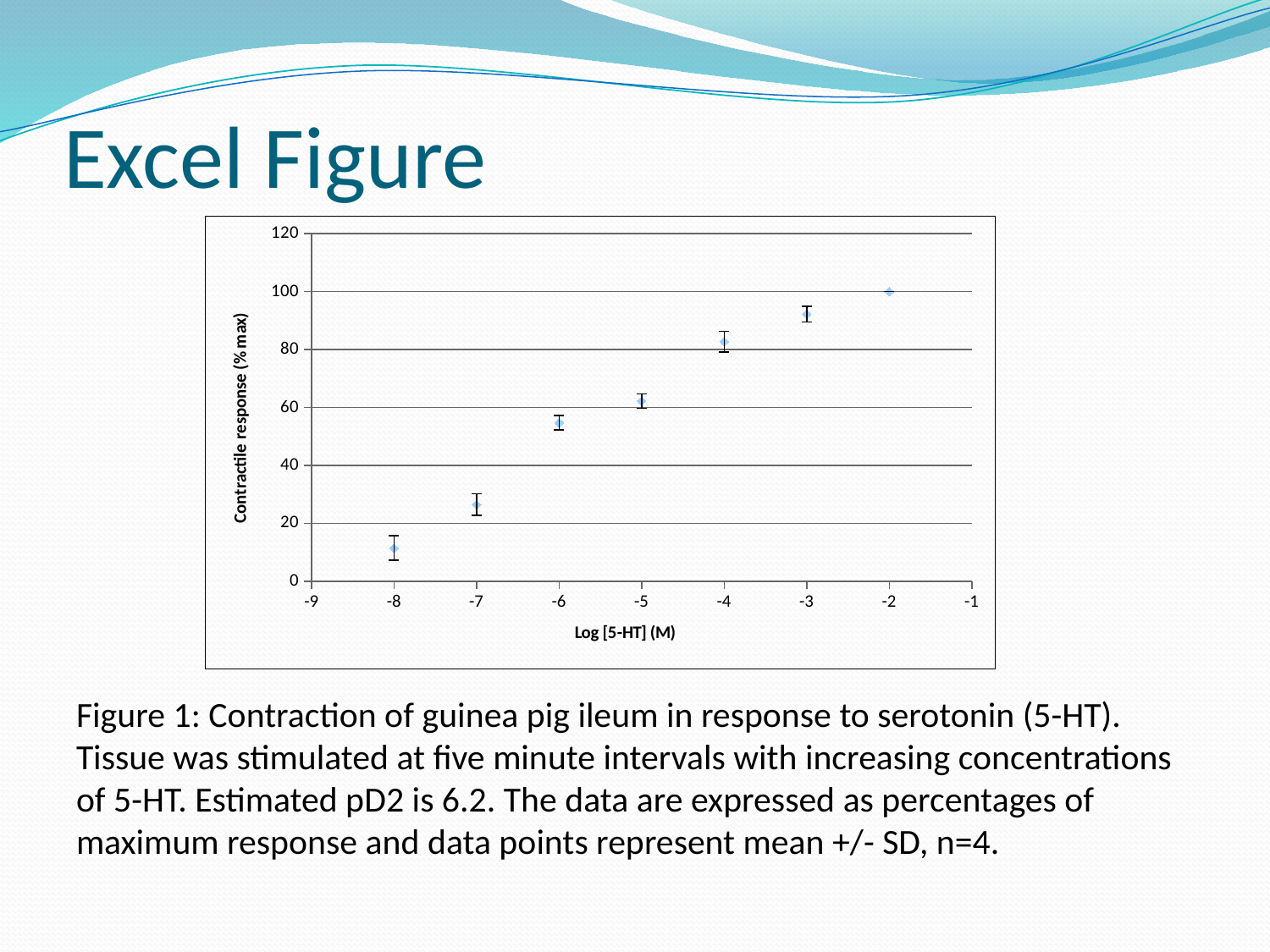
Is the contractile response at Log [5-HT] = -4 greater or less than 80? greater Is the contractile response at Log [5-HT] = -6 greater or less than 60? less What is the contractile response (% max) at Log [5-HT] = -2? 100 What kind of chart is shown on the slide? scatter plot How many data points are plotted on the chart? 7 At which Log [5-HT] (M) value is the contractile response lowest? -8 What is the label of the y axis? Contractile response (% max) Is the contractile response at Log [5-HT] = -8 greater or less than 20? less At which Log [5-HT] (M) value is the contractile response highest? -2 Do the contractile response values rise or fall as Log [5-HT] (M) increases along the x axis? rise What is the label of the x axis? Log [5-HT] (M) Which has the larger contractile response: Log [5-HT] = -7 or Log [5-HT] = -5? -5